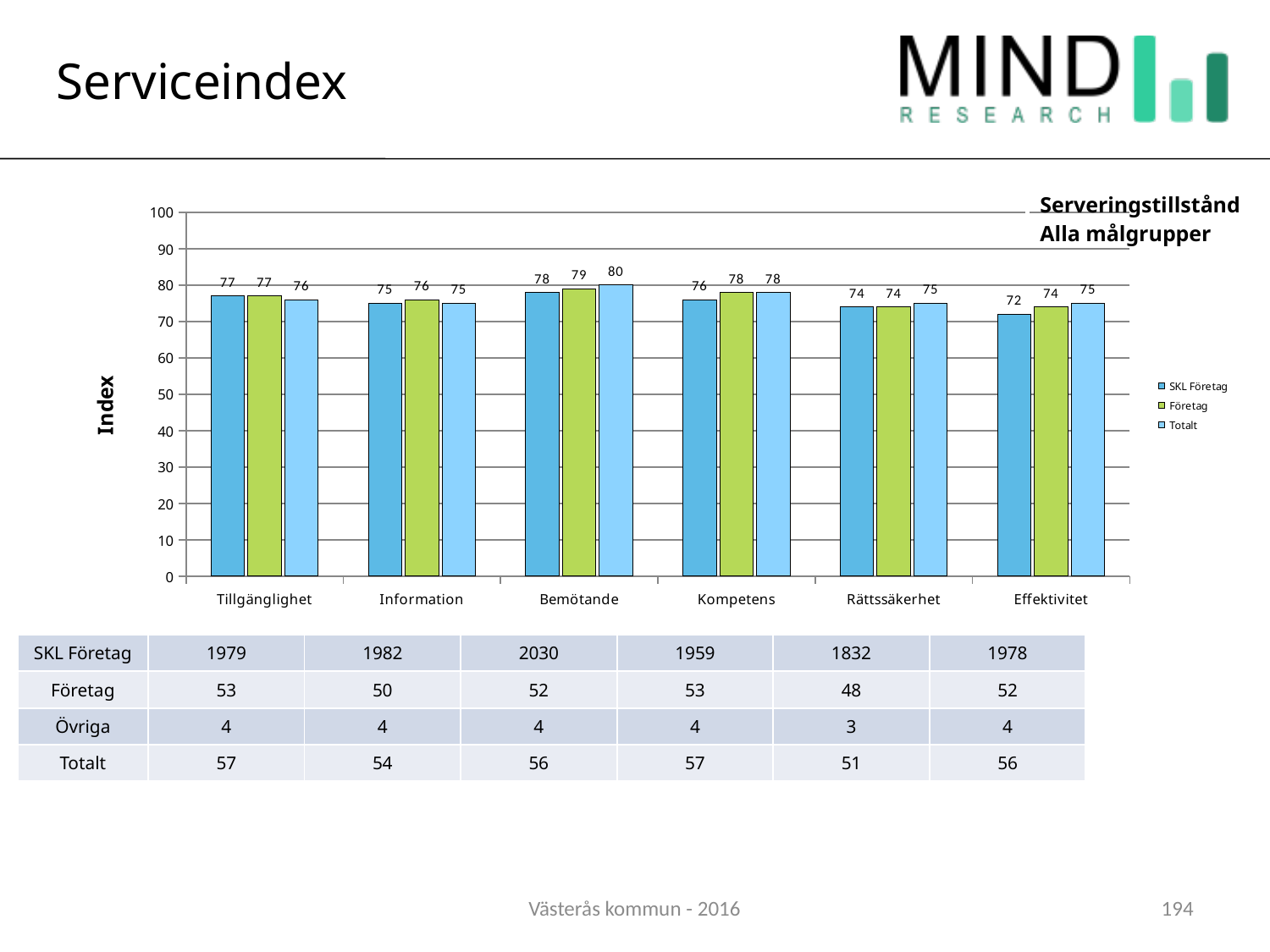
How many series does the chart legend list? 3 What kind of chart is shown on the slide? bar chart What is the label on the vertical axis of the chart? Index What is the value for SKL Företag in the Effektivitet category? 72 Which category has the highest value for the Totalt series? Bemötande How many categories are shown on the x axis of the chart? 6 Which is larger: the SKL Företag value for Tillgänglighet or the SKL Företag value for Effektivitet? Tillgänglighet Which category has the lowest value for the SKL Företag series? Effektivitet What is the value for Företag in the Kompetens category? 78 What is the value for Totalt in the Bemötande category? 80 What is the difference between the Totalt value for Bemötande and the Totalt value for Rättssäkerhet? 5 Is the value for Företag in the Information category greater or less than 70? greater